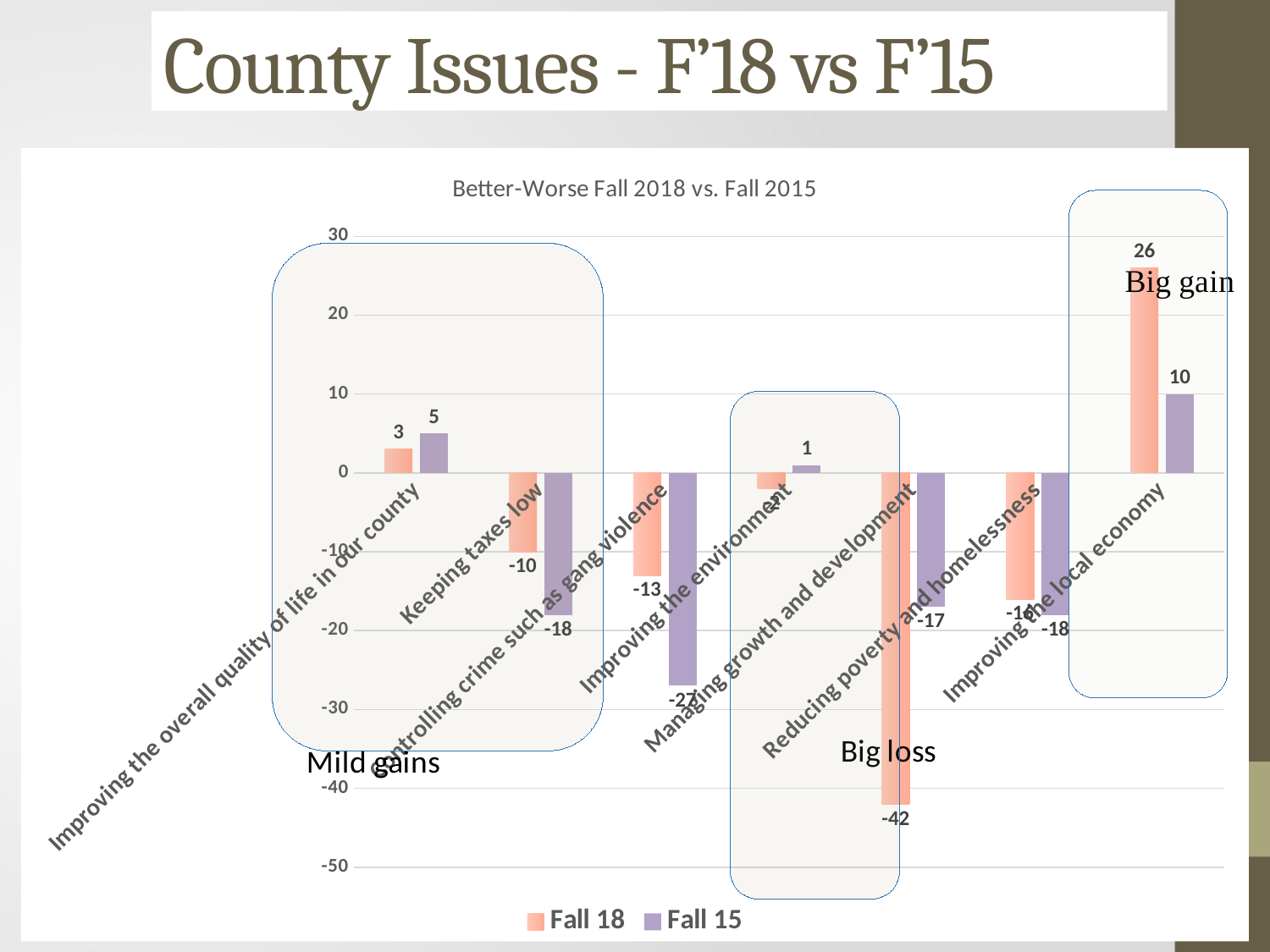
Is the Fall 15 value for Controlling crime such as gang violence greater or less than -20? less What kind of chart is shown on the slide? bar chart What is the Fall 15 value for Improving the local economy? 10 Which category has the lowest Fall 18 value? Managing growth and development What is the Fall 18 value for Improving the local economy? 26 What is the Fall 18 value for Managing growth and development? -42 What is the Fall 15 value for Keeping taxes low? -18 How many series does the legend list? 2 How many categories are plotted on the chart? 7 For Keeping taxes low, which is larger, the Fall 18 value or the Fall 15 value? Fall 18 Which category has the highest Fall 18 value? Improving the local economy For Improving the local economy, what is the difference between the Fall 18 and Fall 15 values? 16